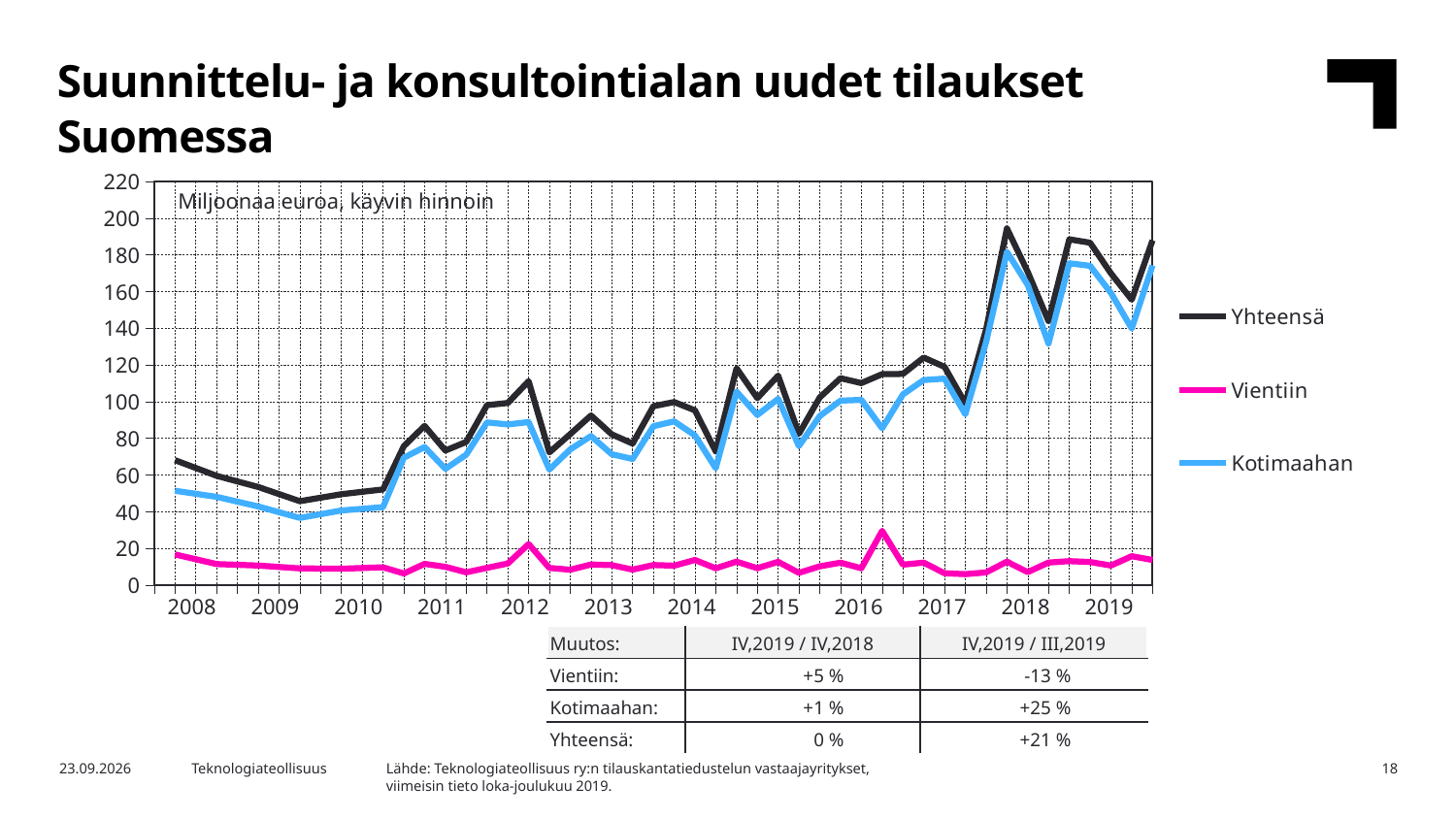
Is the peak value of Yhteensä in 2017 greater or less than 180? less Is the highest value of Vientiin (in 2016) greater or less than 40? less Is the value of Yhteensä at the start of 2008 greater or less than 80? less How many series does the legend list? 3 What unit is stated in the text box inside the chart? Miljoonaa euroa, käyvin hinnoin Which series has the highest values throughout the chart? Yhteensä Which series are listed in the legend? Yhteensä, Vientiin, Kotimaahan Which series has the lowest values throughout the chart? Vientiin How many years are labelled on the x axis? 12 Does the Yhteensä series overall rise or fall from 2008 to 2019? rise Which series is larger in 2019, Kotimaahan or Vientiin? Kotimaahan What kind of chart is shown on the slide? line chart